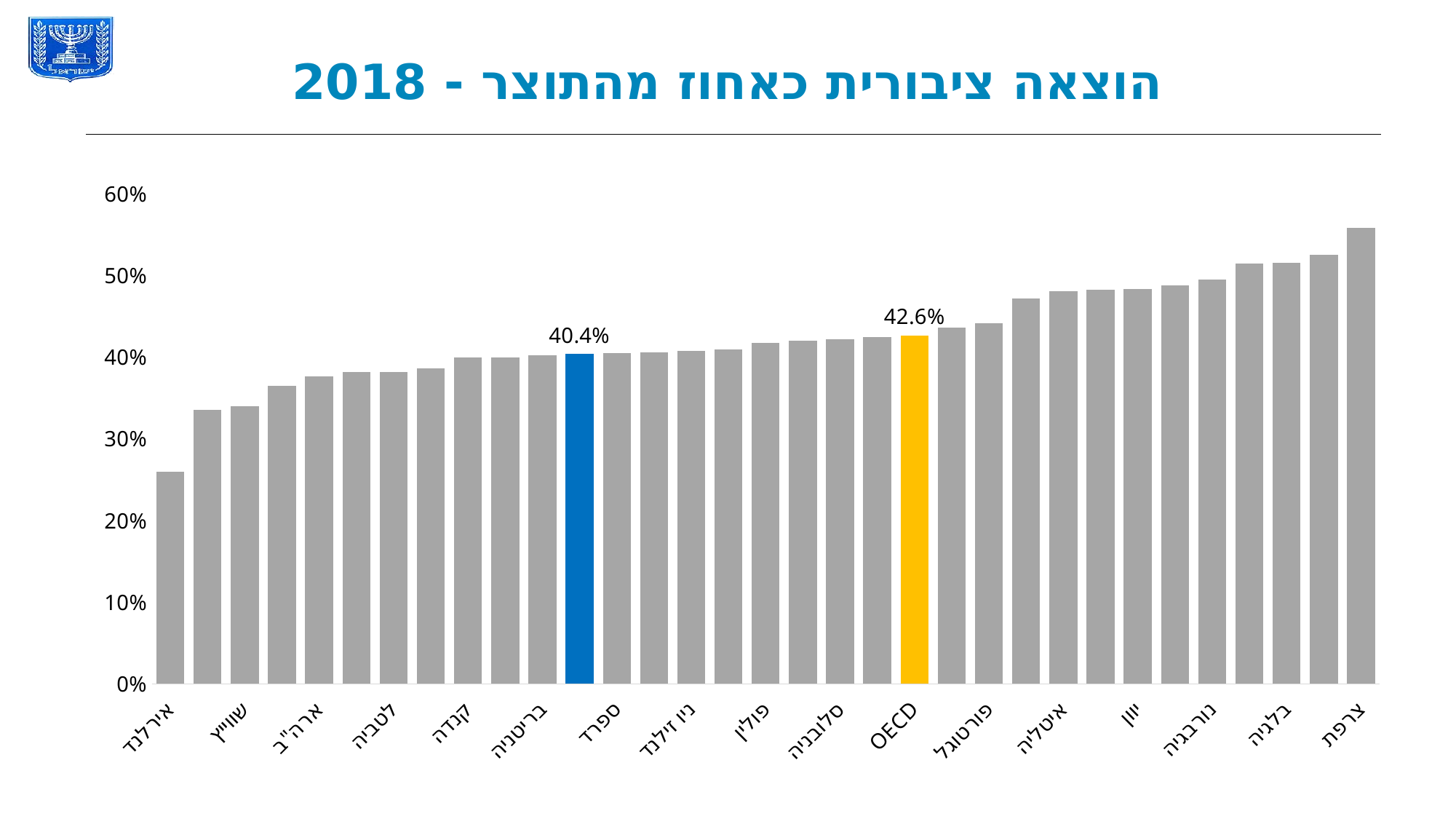
Which labeled country has the highest value? צרפת What is the title of the chart? הוצאה ציבורית כאחוז מהתוצר - 2018 Is the value for יוון greater or less than 40%? greater What colour is the OECD bar? yellow Is the value for אירלנד greater or less than 30%? less Which is larger, the OECD value or the value of the blue bar? OECD Do the bar values rise or fall from left to right along the x axis? rise What value is labeled on the blue bar? 40.4% Which labeled country has the lowest value? אירלנד What is the difference between the OECD value and the value labeled on the blue bar? 2.2% What value is shown for OECD? 42.6% What kind of chart is shown on the slide? bar chart